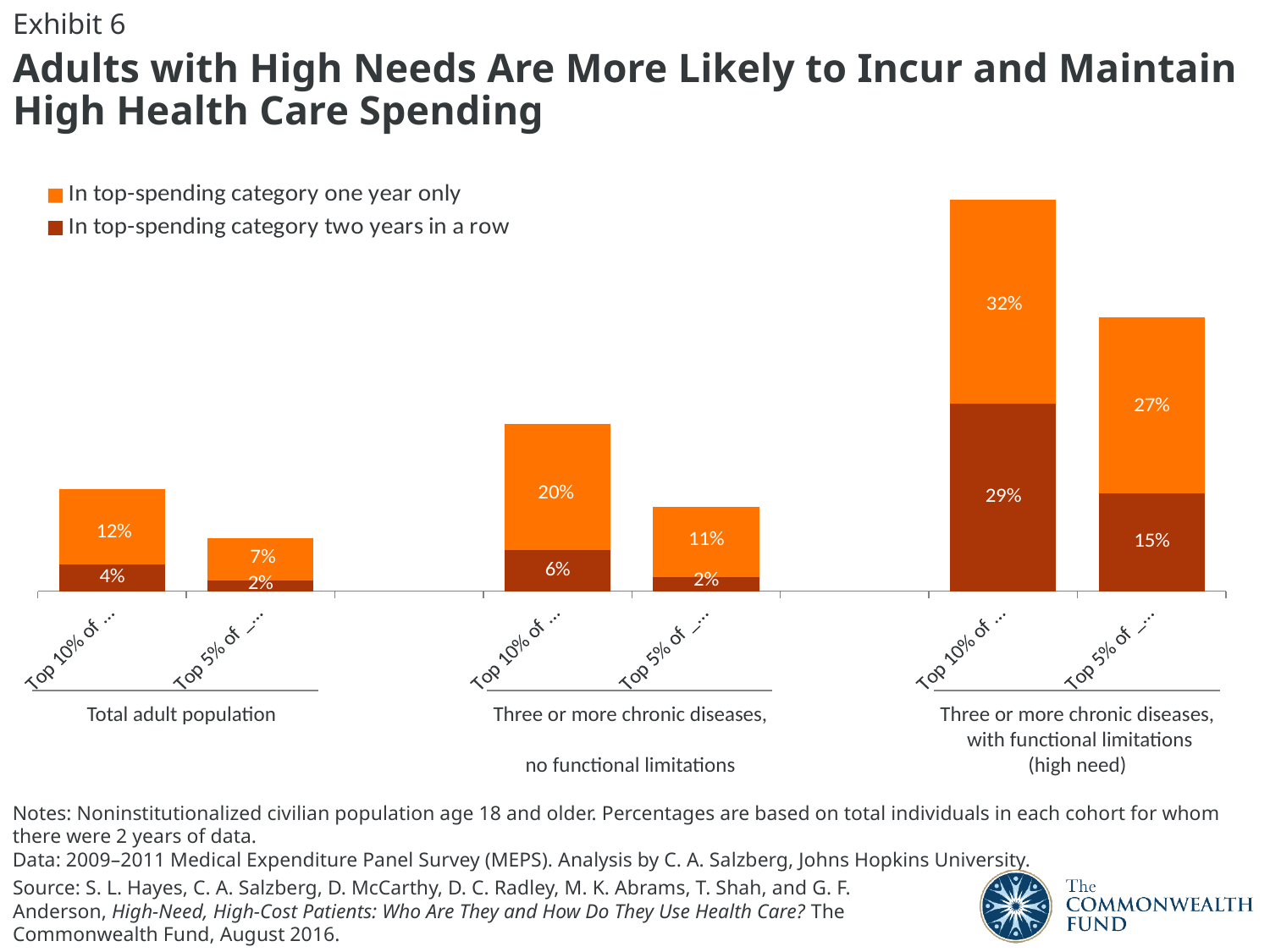
Which bar has the lowest value for 'In top-spending category one year only'? Top 5% in the Total adult population group (7%) What kind of chart is shown on the slide? Stacked bar chart Which bar has the highest value for 'In top-spending category one year only'? Top 10% in the high need group (32%) How many series does the legend list? 2 What is the total height of the Top 10% stacked bar in the 'Three or more chronic diseases, with functional limitations (high need)' group? 61% What is the value for 'In top-spending category one year only' for the Top 5% bar in the 'Total adult population' group? 7% How many population groups are shown along the x axis? 3 What is the total height of the Top 10% stacked bar in the 'Total adult population' group? 16% What is the value for 'In top-spending category two years in a row' for the Top 10% bar in the 'Three or more chronic diseases, with functional limitations (high need)' group? 29% What is the difference between the 'two years in a row' values for the Top 10% bars in the high need group and the Total adult population group? 25 percentage points What is the value for 'In top-spending category one year only' for the Top 10% bar in the 'Three or more chronic diseases, no functional limitations' group? 20% Which is larger: the 'one year only' value for the Top 5% bar in the high need group or the 'one year only' value for the Top 10% bar in the 'no functional limitations' group? Top 5% in the high need group (27%)